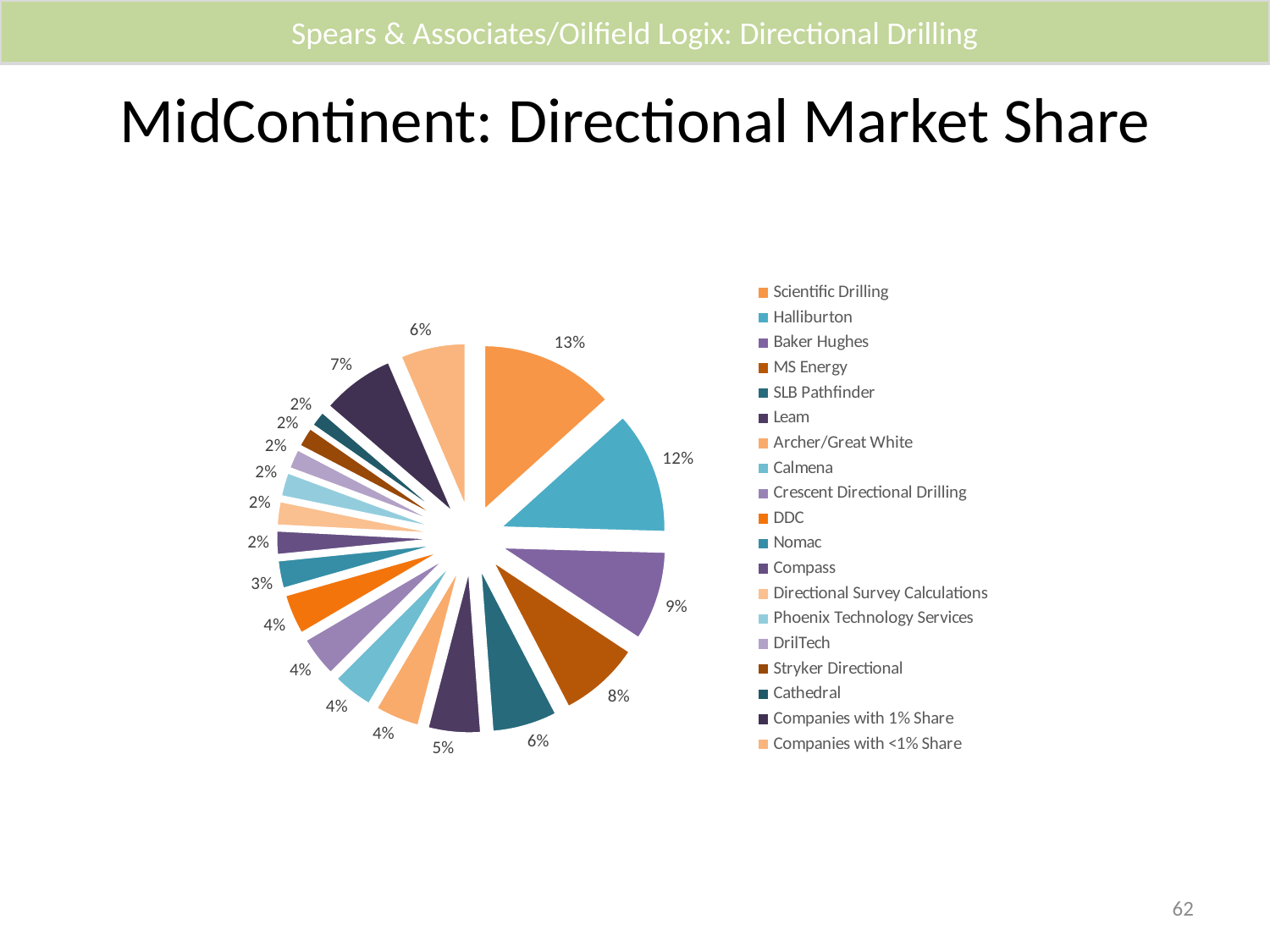
Which company has the largest slice of the pie? Scientific Drilling Which has a larger market share, Baker Hughes or MS Energy? Baker Hughes What is the market share for Baker Hughes? 9% What is the market share for Halliburton? 12% How many entries does the legend list? 19 What is the market share for Nomac? 3% What is the difference in market share between Scientific Drilling and Halliburton? 1% What is the market share for MS Energy? 8% What is the market share for Scientific Drilling? 13% What is the title of the chart? MidContinent: Directional Market Share What is the share for Companies with 1% Share? 7% What type of chart is shown on the slide? pie chart